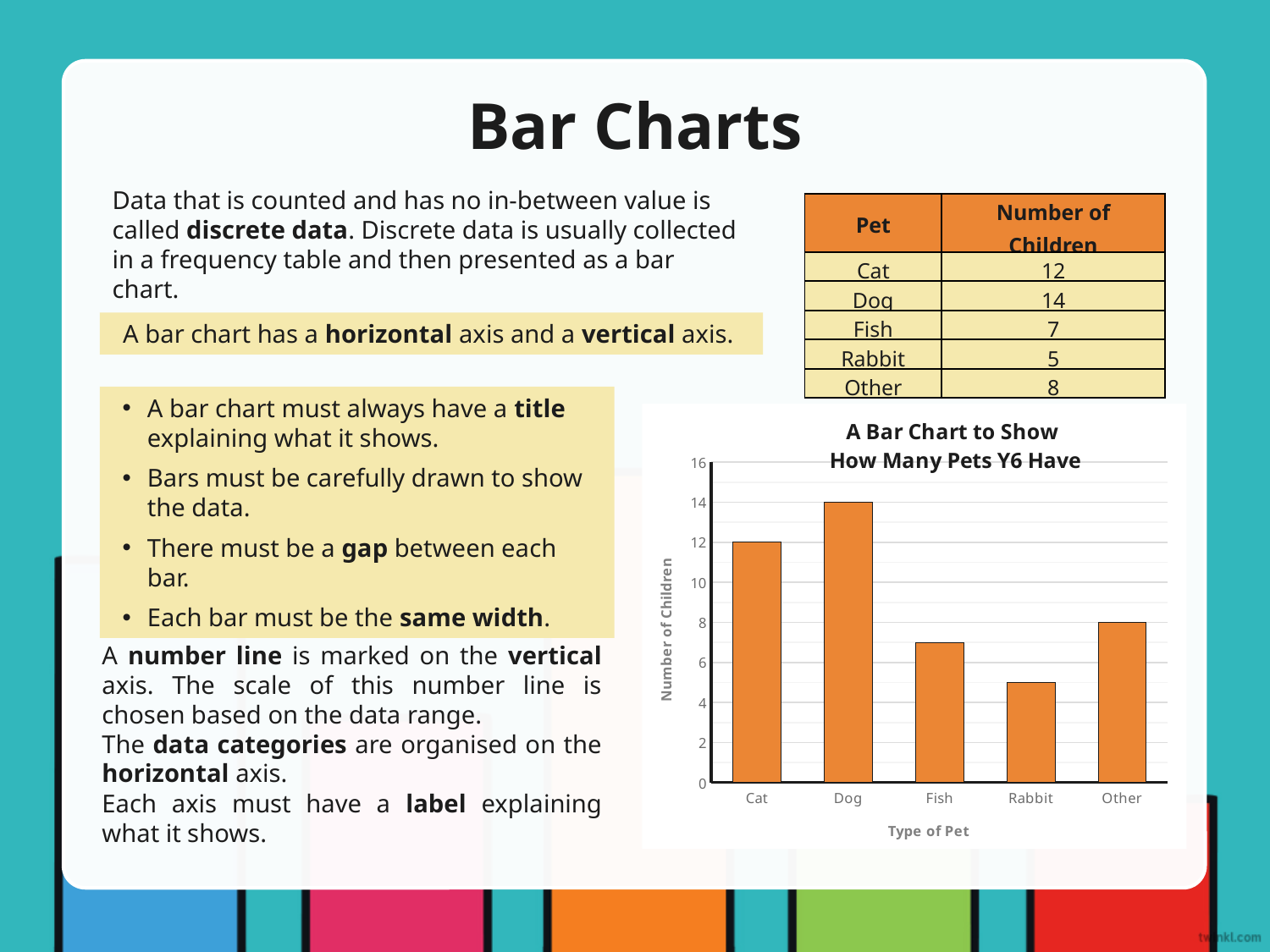
How many children have a cat according to the chart? 12 What is the title of the chart? A Bar Chart to Show How Many Pets Y6 Have What type of chart is shown on the slide? Bar chart What is the difference between the values for Cat and Other? 4 How many children have a dog according to the chart? 14 What is the value for Other on the chart? 8 How many types of pet are shown on the horizontal axis? 5 How many more children have a dog than a cat? 2 Is the value for Fish greater or less than 8? less Which type of pet has the lowest bar? Rabbit Which type of pet has the highest bar? Dog Which is larger, the value for Fish or the value for Other? Other